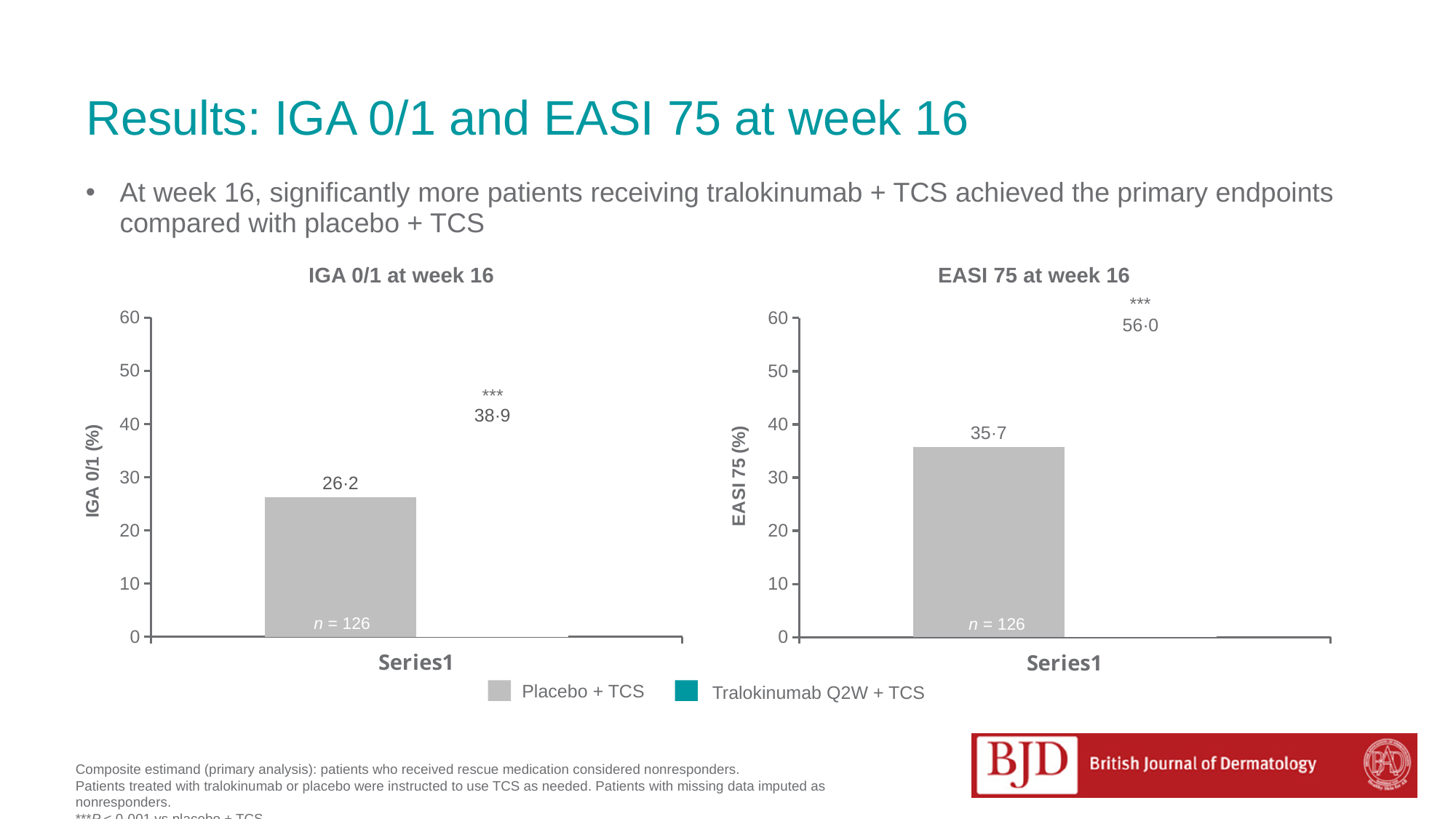
On the IGA 0/1 at week 16 chart, what is the value for Placebo + TCS? 26·2 On the IGA 0/1 at week 16 chart, is the Placebo + TCS bar greater or less than 30? less What kind of chart is the IGA 0/1 at week 16 chart? bar chart On the EASI 75 at week 16 chart, is the Placebo + TCS bar greater or less than 30? greater On the EASI 75 at week 16 chart, what is the difference between the Tralokinumab Q2W + TCS value and the Placebo + TCS value? 20·3 On the EASI 75 at week 16 chart, what is the value for Placebo + TCS? 35·7 On the IGA 0/1 at week 16 chart, what value is labelled for Tralokinumab Q2W + TCS? 38·9 What is the y-axis label of the EASI 75 at week 16 chart? EASI 75 (%) How many series does the shared legend list? 2 On the IGA 0/1 at week 16 chart, what is the difference between the Tralokinumab Q2W + TCS value and the Placebo + TCS value? 12·7 On the EASI 75 at week 16 chart, which group has the higher value, Placebo + TCS or Tralokinumab Q2W + TCS? Tralokinumab Q2W + TCS On the EASI 75 at week 16 chart, what value is labelled for Tralokinumab Q2W + TCS? 56·0